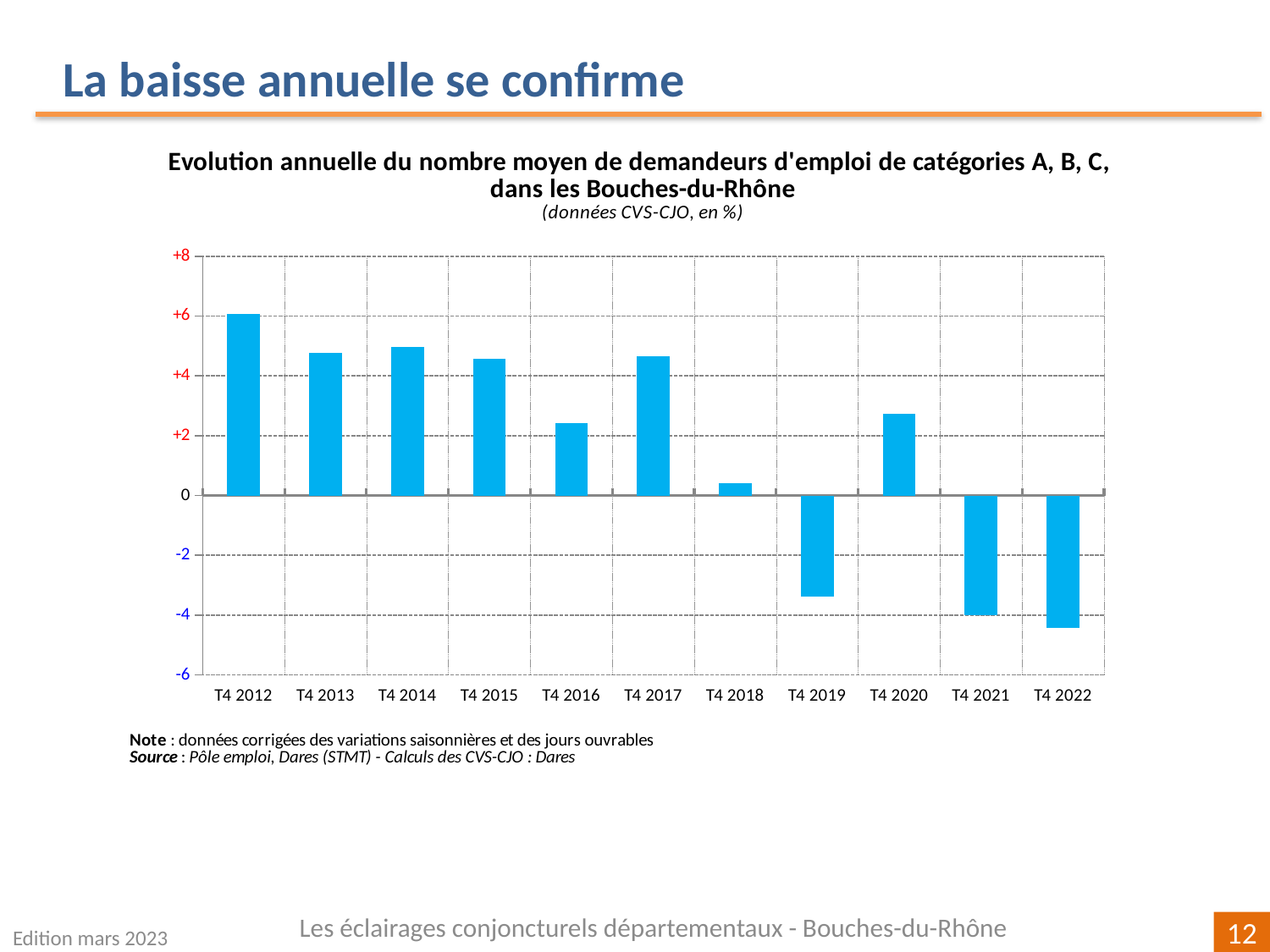
Is the value for T4 2012 greater or less than +4? greater Is the value for T4 2016 greater or less than +2? greater In what unit are the data expressed, according to the chart subtitle? % Is the value for T4 2022 greater or less than -4? less How many quarters (categories) are plotted on the x axis? 11 Which quarter has the lowest annual change? T4 2022 Which is larger, the value for T4 2016 or the value for T4 2017? T4 2017 Overall, do the values rise or fall from T4 2012 to T4 2022? fall Which quarter has the highest annual change? T4 2012 What kind of chart is shown on the slide? bar chart